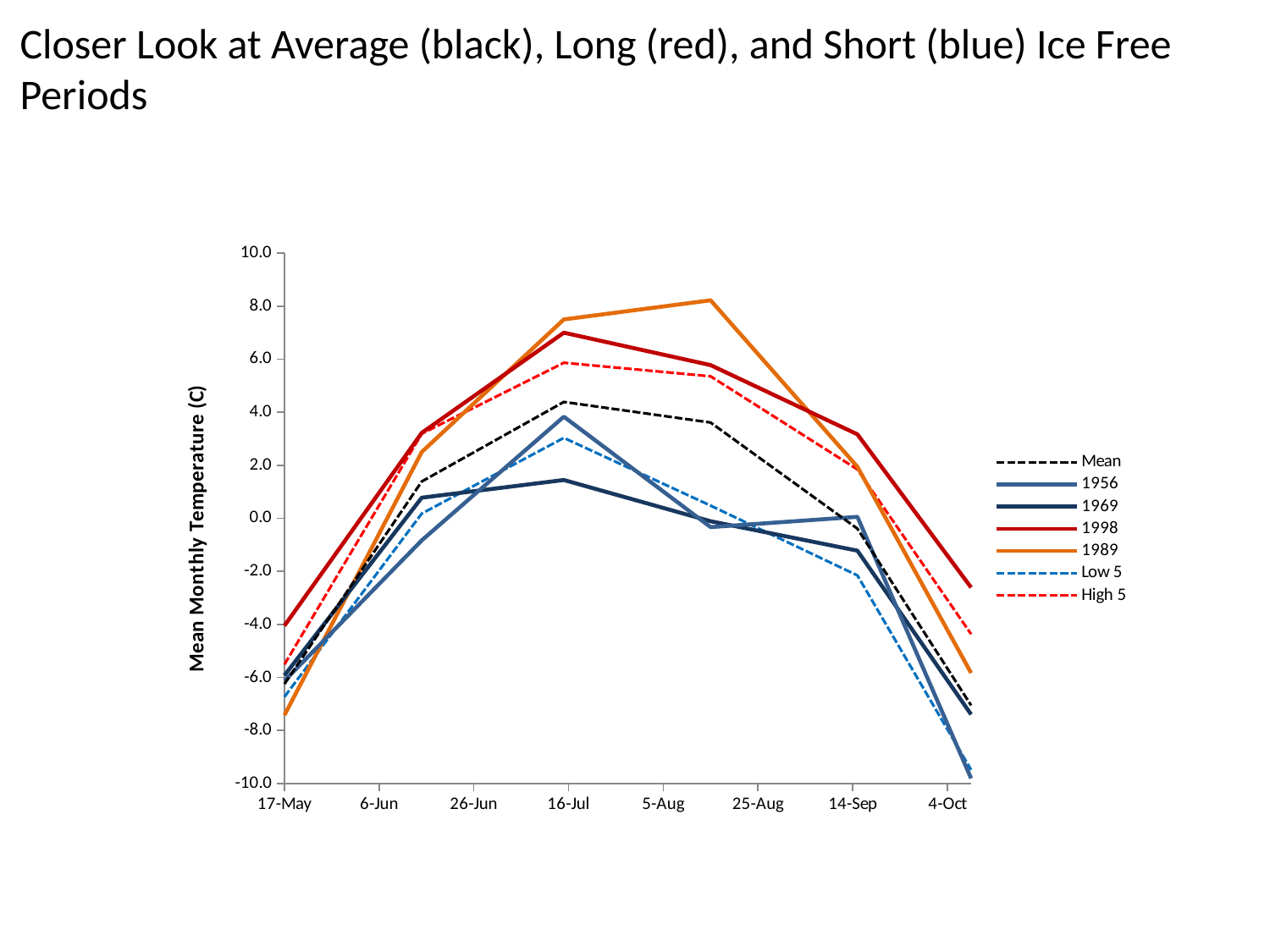
At 16-Jul, which series has the higher value, 1956 or 1969? 1956 At 14-Sep, which series has the higher value, 1998 or 1989? 1998 Is the value for 1969 at 16-Jul greater or less than 2.0? less What kind of chart is shown on the slide? line chart Which series reaches the highest value on the chart? 1989 What is the title of the vertical axis? Mean Monthly Temperature (C) Is the value for 1998 at 4-Oct greater or less than -4.0? greater Is the value for 1989 at 17-May greater or less than -6.0? less Does the Mean series rise or fall between 17-May and 16-Jul? rise How many series does the legend list? 7